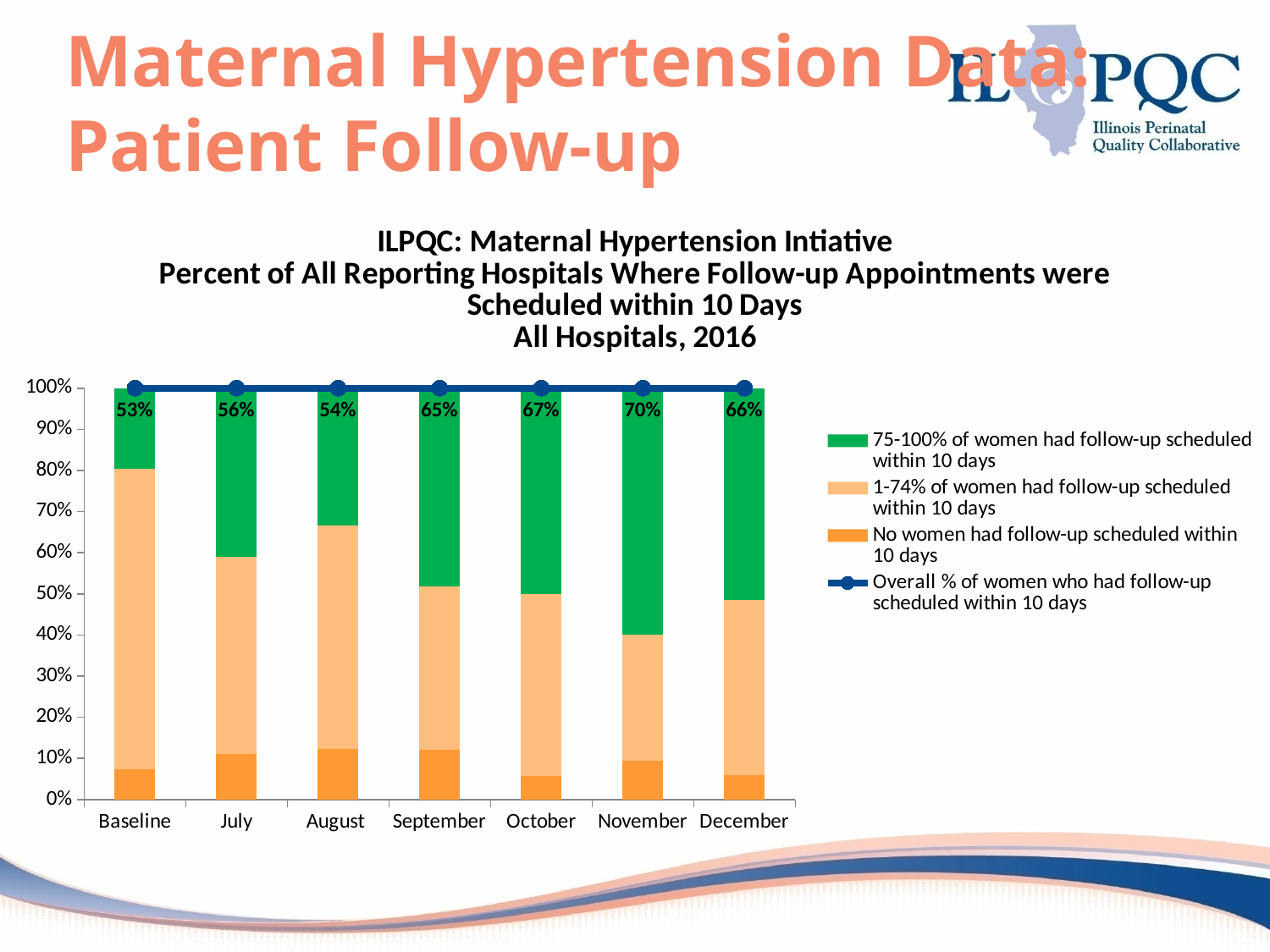
Is the 'No women had follow-up scheduled within 10 days' segment for Baseline greater or less than 10%? less By how many percentage points does the overall percentage in November exceed the Baseline value? 17 percentage points Which period has the lowest overall percentage of women who had follow-up scheduled within 10 days? Baseline How many series does the legend list? 4 What kind of chart is used to show the hospital categories? Stacked bar chart How many categories are shown on the x axis? 7 Which is larger, the overall percentage for October or for September? October What is the overall percentage of women who had follow-up scheduled within 10 days in November? 70% What is the overall percentage of women who had follow-up scheduled within 10 days at Baseline? 53% What is the overall percentage of women who had follow-up scheduled within 10 days in September? 65% Is the '75-100% of women had follow-up scheduled within 10 days' segment for November greater or less than 50%? greater Which month has the highest overall percentage of women who had follow-up scheduled within 10 days? November